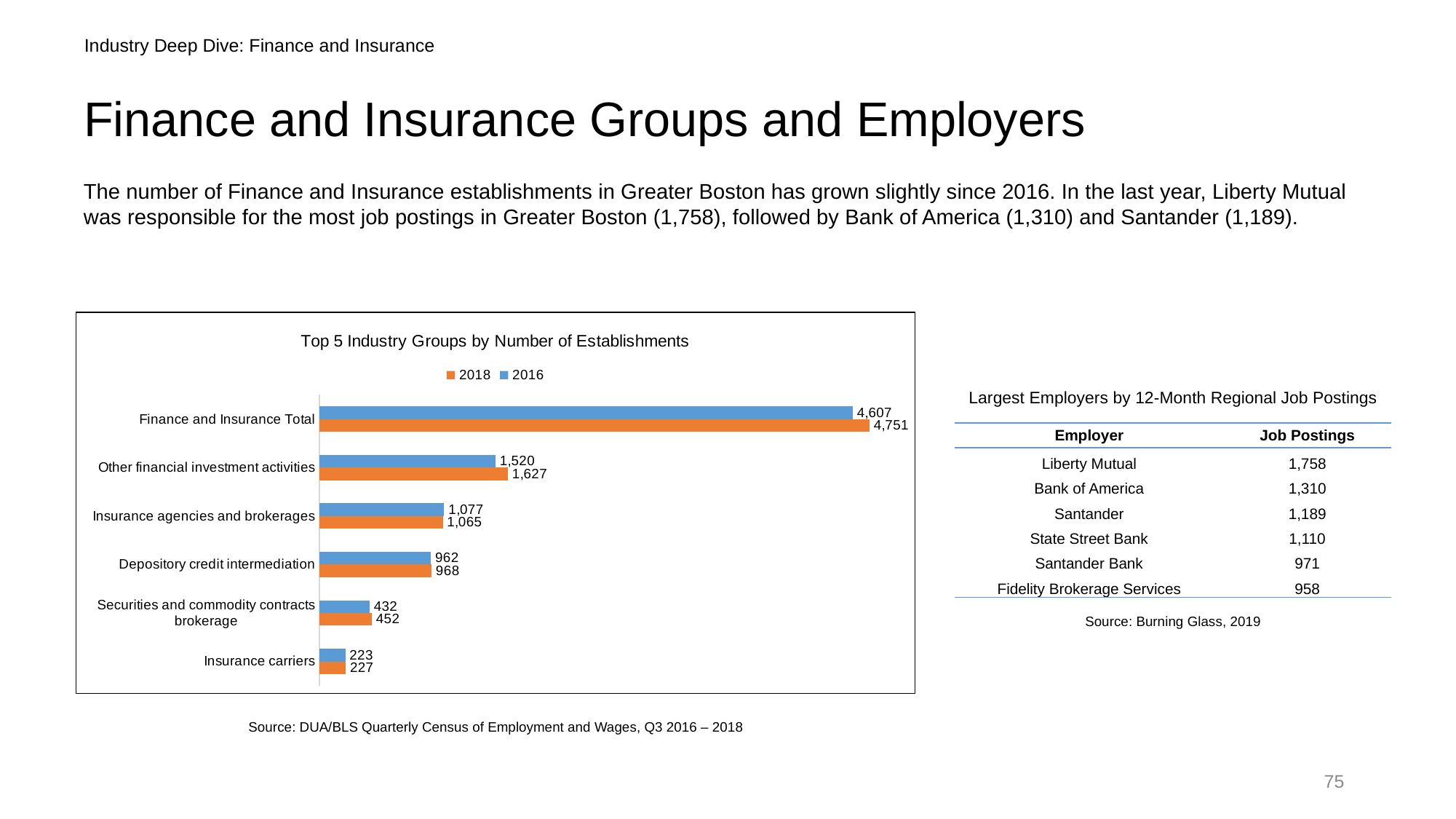
What type of chart is used to show the Top 5 Industry Groups by Number of Establishments? Bar chart How many series does the chart legend list? 2 What is the difference between the 2018 and 2016 values for Securities and commodity contracts brokerage? 20 For Insurance agencies and brokerages, which year has the larger value, 2016 or 2018? 2016 What is the 2018 value for Insurance agencies and brokerages? 1,065 What is the difference between the 2018 and 2016 values for Finance and Insurance Total? 144 How many industry group categories are shown on the chart? 6 What is the 2016 value for Insurance carriers? 223 What is the 2018 value for Finance and Insurance Total in the Top 5 Industry Groups by Number of Establishments chart? 4,751 Which category has the lowest number of establishments in 2018? Insurance carriers What is the 2016 value for Other financial investment activities? 1,520 Excluding the Finance and Insurance Total, which industry group has the highest number of establishments in 2016? Other financial investment activities